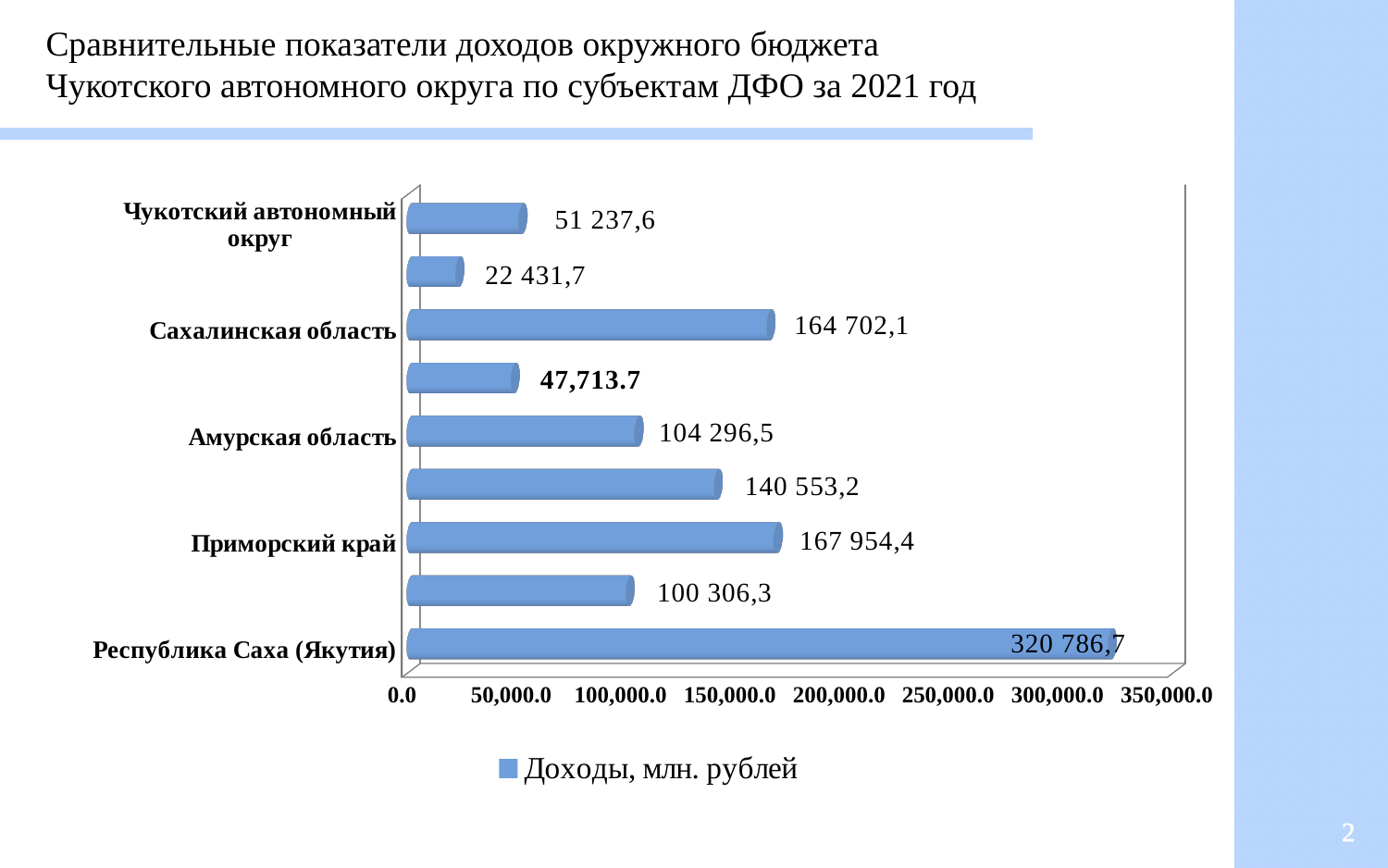
How many bars are plotted on the chart? 9 What is the difference between the values for Приморский край and Сахалинская область? 3 252,3 What is the legend entry for the series? Доходы, млн. рублей What is the value for Сахалинская область? 164 702,1 Is the value for Чукотский автономный округ greater or less than 100,000.0? less What is the value for Чукотский автономный округ? 51 237,6 What is the value for Республика Саха (Якутия)? 320 786,7 Which is larger, the value for Амурская область or the value for Чукотский автономный округ? Амурская область What is the value for Амурская область? 104 296,5 What type of chart is shown on the slide? bar chart Which labelled region has the highest value? Республика Саха (Якутия) What is the smallest value shown on the chart? 22 431,7